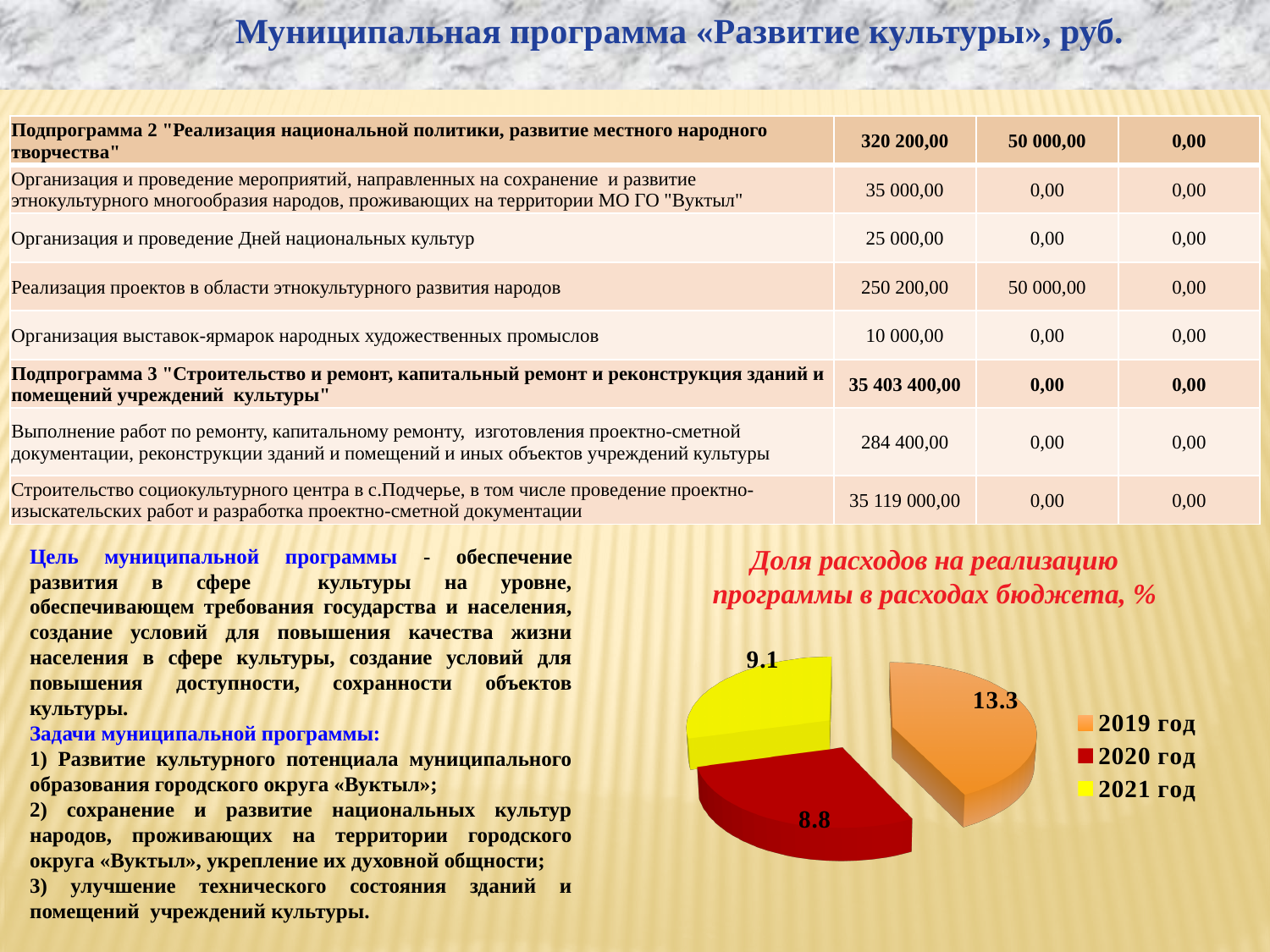
Which year has the largest slice in the pie chart? 2019 год What is the value for 2021 год in the pie chart? 9.1 Which is larger in the pie chart, the value for 2019 год or the value for 2021 год? 2019 год What is the difference between the values for 2021 год and 2020 год in the pie chart? 0.3 What is the value for 2019 год in the pie chart? 13.3 What kind of chart is shown on the slide? pie chart Which year has the smallest slice in the pie chart? 2020 год What is the difference between the values for 2019 год and 2020 год in the pie chart? 4.5 How many slices does the pie chart have? 3 What colour is the slice for 2021 год in the pie chart? yellow What is the title of the pie chart? Доля расходов на реализацию программы в расходах бюджета, % What is the value for 2020 год in the pie chart? 8.8